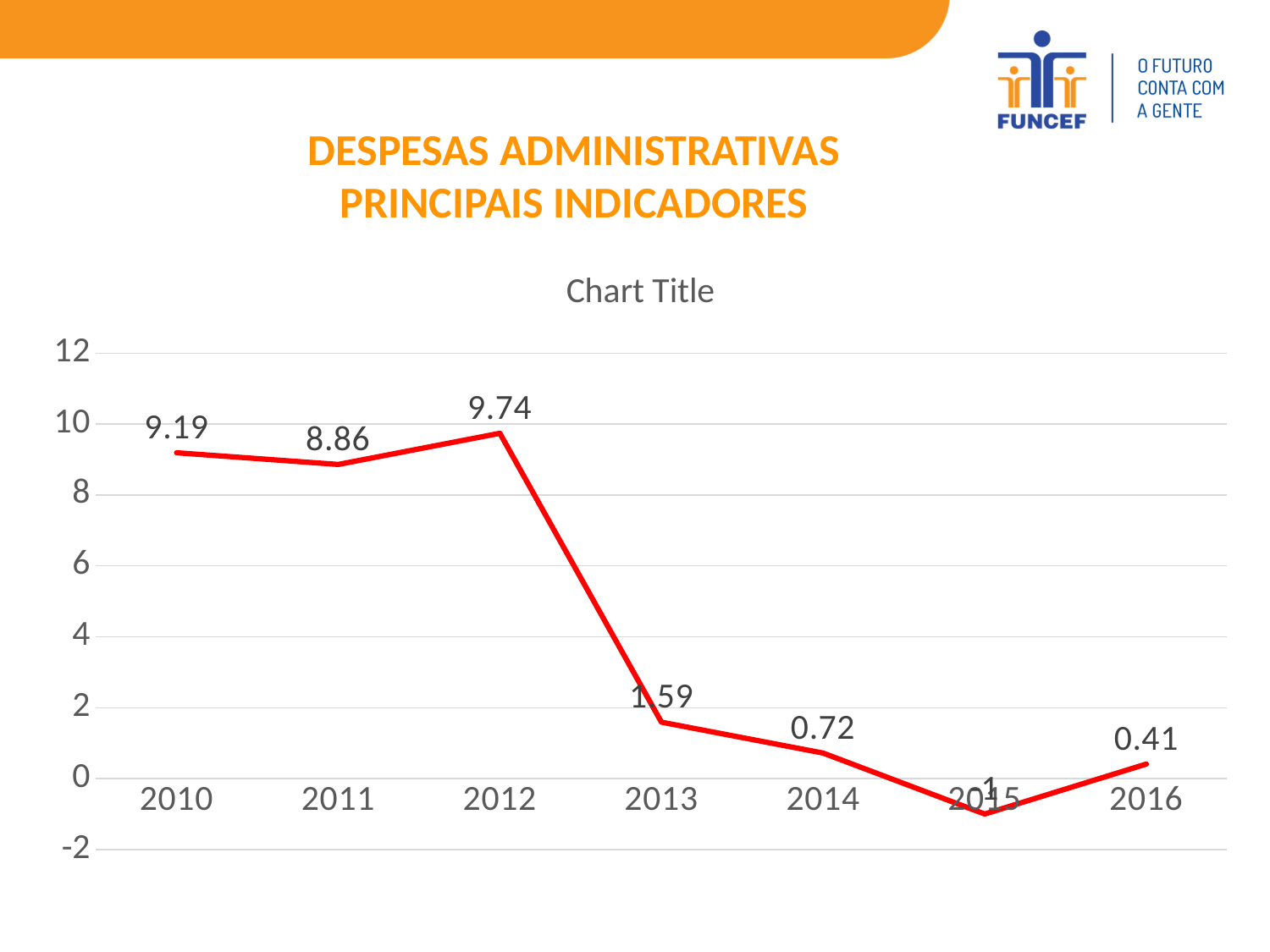
What is the difference between the values for 2012 and 2011? 0.88 Which year has the highest value? 2012 What is the value for 2012? 9.74 Which is larger, the value for 2010 or the value for 2011? 2010 How many years are plotted on the x axis? 7 What is the value for 2016? 0.41 What is the value for 2010? 9.19 What type of chart is shown on the slide? line chart What is the value for 2013? 1.59 Is the value for 2015 greater or less than 0? less Does the line generally rise or fall from 2012 to 2015? fall Which year has the lowest value? 2015